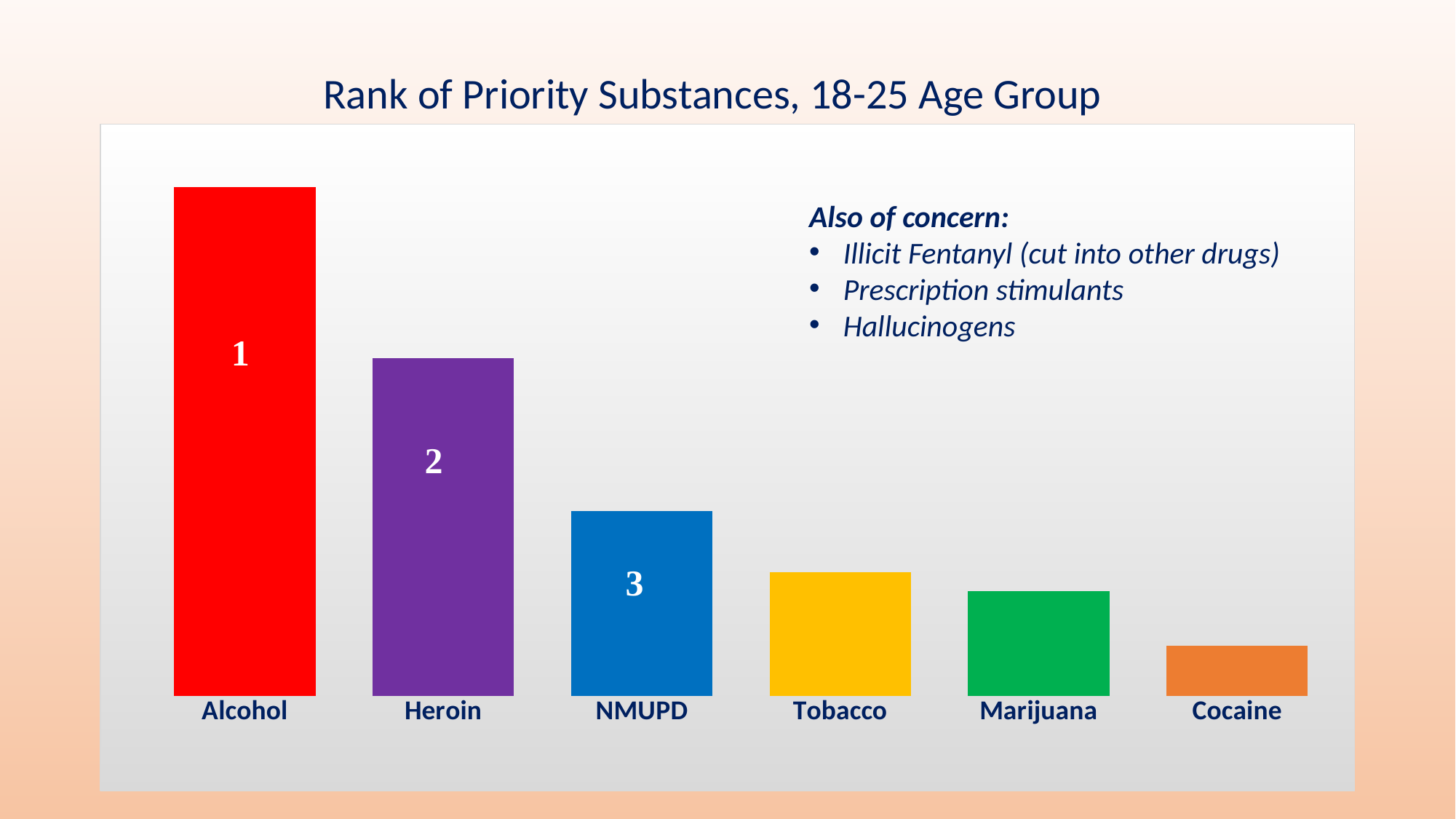
Which bar is taller, Tobacco or Marijuana? Tobacco Which substance has the shortest bar in the chart? Cocaine Which substance has the tallest bar in the chart? Alcohol What rank number is printed on the Alcohol bar? 1 Which substance is ranked 3 in the chart? NMUPD Which bar is taller, Heroin or NMUPD? Heroin How many substances (categories) are shown in the chart? 6 Do the bars rise or fall from left to right across the chart? fall What rank number is printed on the NMUPD bar? 3 What rank number is printed on the Heroin bar? 2 What is the title of the chart? Rank of Priority Substances, 18-25 Age Group What kind of chart is shown on the slide? bar chart